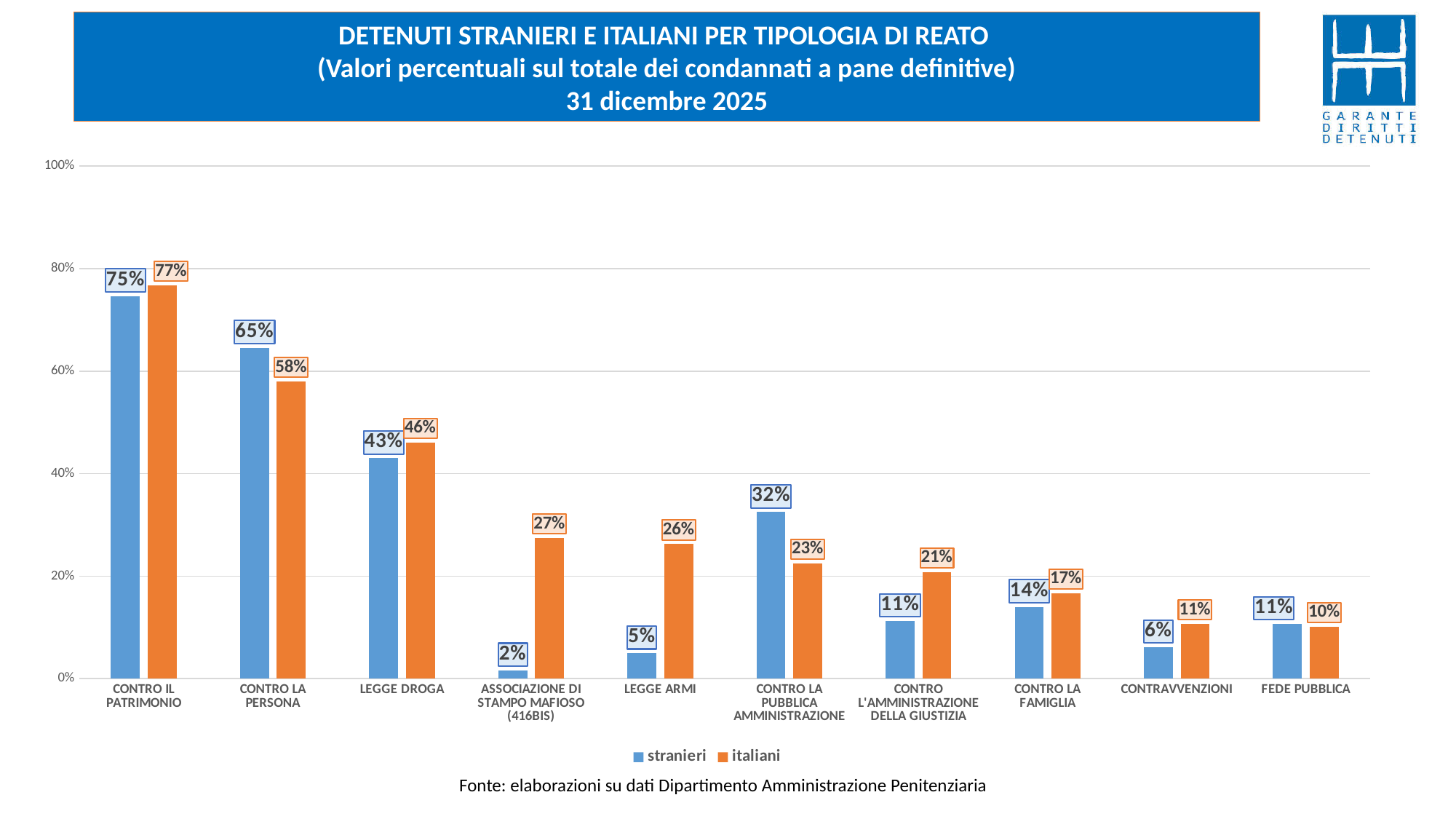
What is the difference between the italiani and stranieri values in the ASSOCIAZIONE DI STAMPO MAFIOSO (416BIS) category? 25% What kind of chart is shown on the slide? bar chart What is the value for stranieri in the ASSOCIAZIONE DI STAMPO MAFIOSO (416BIS) category? 2% What is the value for italiani in the LEGGE ARMI category? 26% How many categories are shown on the x axis? 10 Is the value for italiani in the CONTRO LA PUBBLICA AMMINISTRAZIONE category greater or less than 20%? greater In the CONTRO LA PERSONA category, which series has the larger value, stranieri or italiani? stranieri Which category has the highest value for italiani? CONTRO IL PATRIMONIO Which category has the lowest value for stranieri? ASSOCIAZIONE DI STAMPO MAFIOSO (416BIS) What is the value for stranieri in the CONTRO IL PATRIMONIO category? 75% Which colour represents the italiani series? orange How many series does the legend list? 2